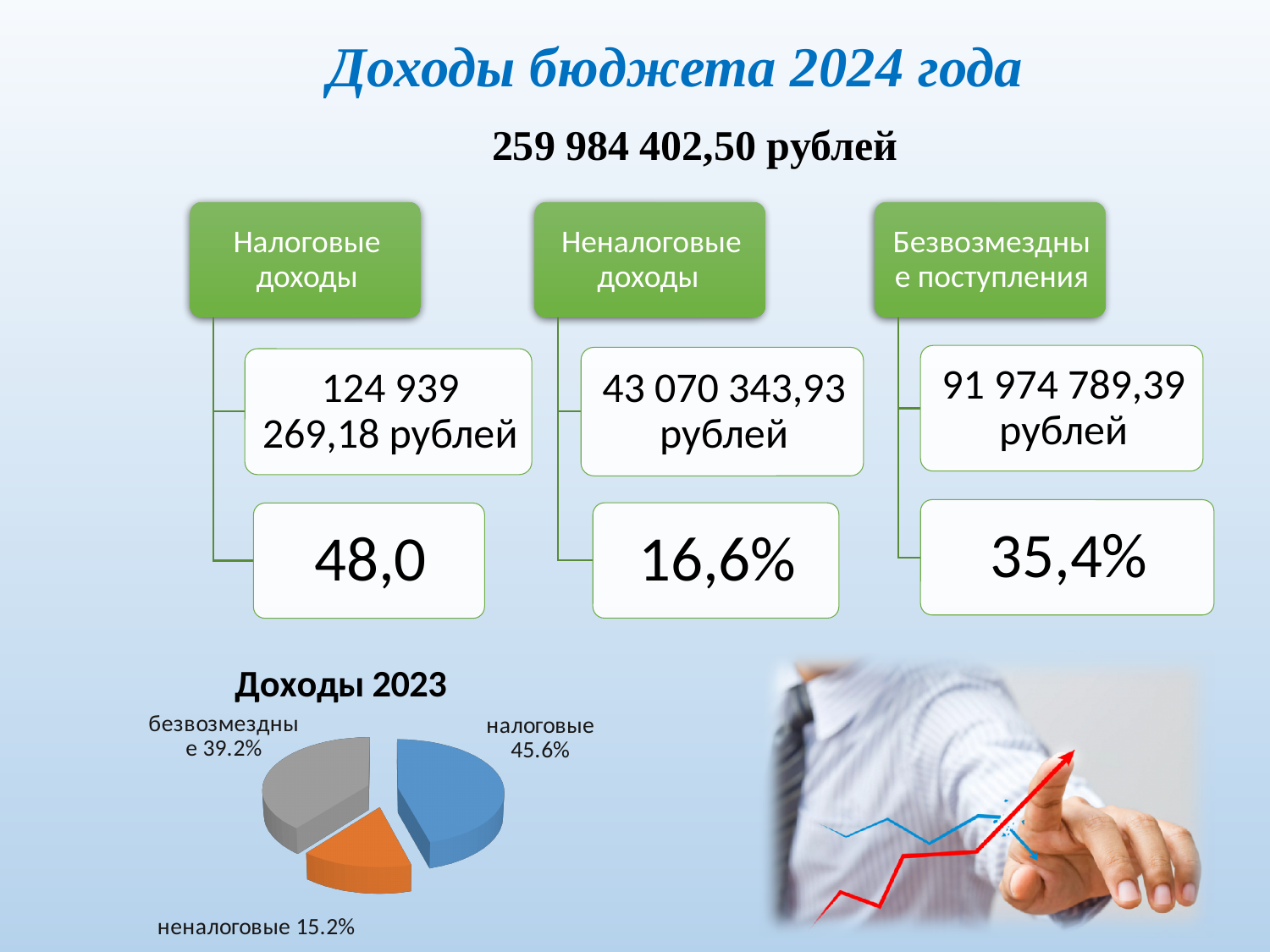
In the pie chart "Доходы 2023", which category has the smallest slice? неналоговые In the pie chart "Доходы 2023", what is the difference in percentage points between безвозмездные and неналоговые? 24.0 In the pie chart "Доходы 2023", what colour is the slice for налоговые? blue In the pie chart "Доходы 2023", what share is labelled for неналоговые? 15.2% In the pie chart "Доходы 2023", which category has the largest slice? налоговые In the pie chart "Доходы 2023", what is the difference in percentage points between налоговые and неналоговые? 30.4 In the pie chart "Доходы 2023", what share is labelled for безвозмездные? 39.2% How many slices does the pie chart "Доходы 2023" have? 3 What is the title of the pie chart on the slide? Доходы 2023 What type of chart is shown at the bottom left of the slide? pie chart In the pie chart "Доходы 2023", which is larger: налоговые or безвозмездные? налоговые In the pie chart "Доходы 2023", what share is labelled for налоговые? 45.6%